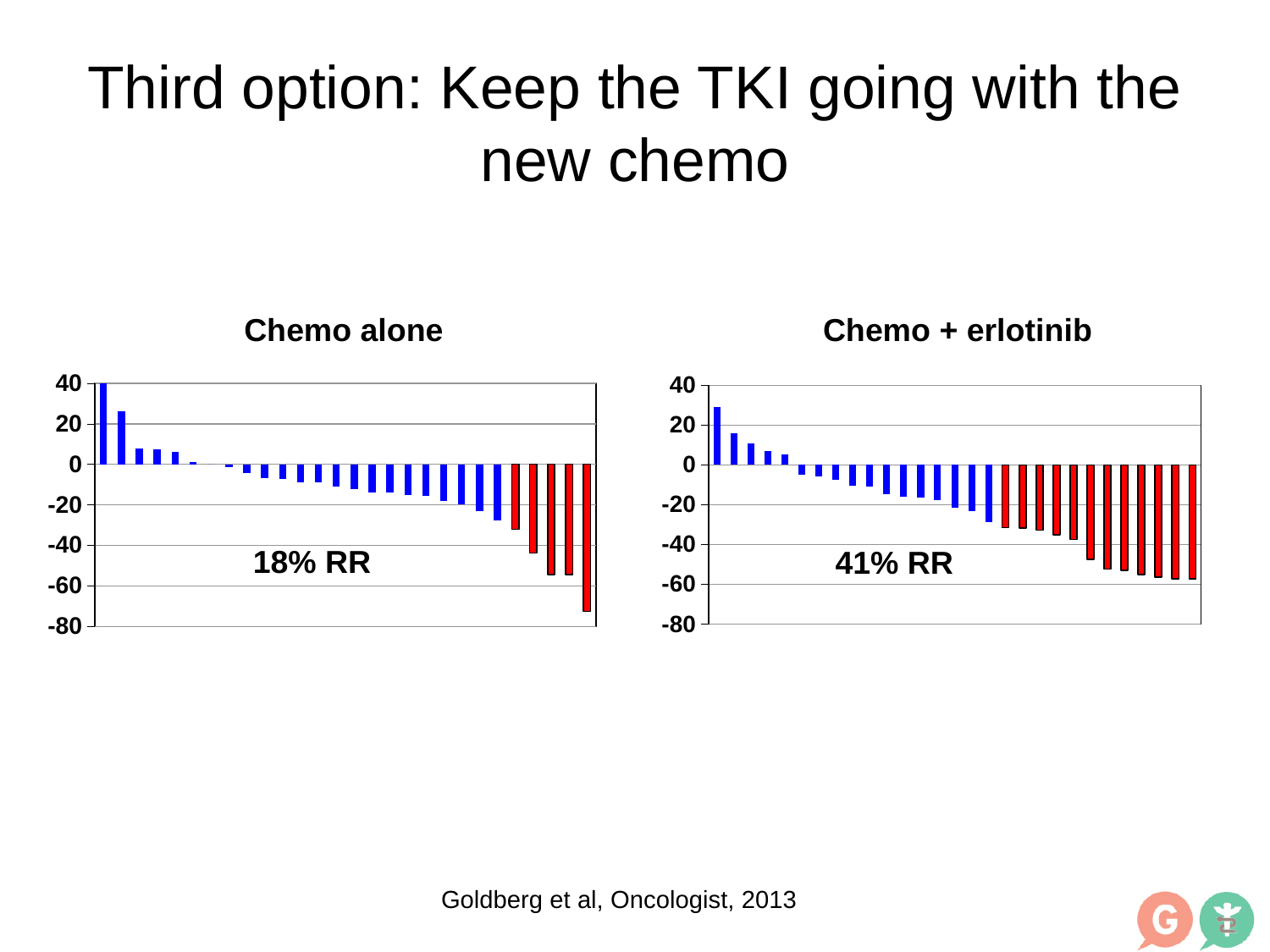
What response rate is printed on the 'Chemo alone' chart? 18% RR In the 'Chemo alone' chart, is the value of the second bar from the left greater or less than 20? greater What kind of chart is the 'Chemo alone' chart? bar chart Do the bar values rise or fall from left to right in the 'Chemo + erlotinib' chart? fall Which chart has the lower minimum bar, 'Chemo alone' or 'Chemo + erlotinib'? Chemo alone In the 'Chemo alone' chart, is the value of the tallest positive bar greater or less than 20? greater Which chart has the taller maximum positive bar, 'Chemo alone' or 'Chemo + erlotinib'? Chemo alone How many red bars are there in the 'Chemo alone' chart? 5 What response rate is printed on the 'Chemo + erlotinib' chart? 41% RR In the 'Chemo alone' chart, is the value of the lowest bar greater or less than -60? less